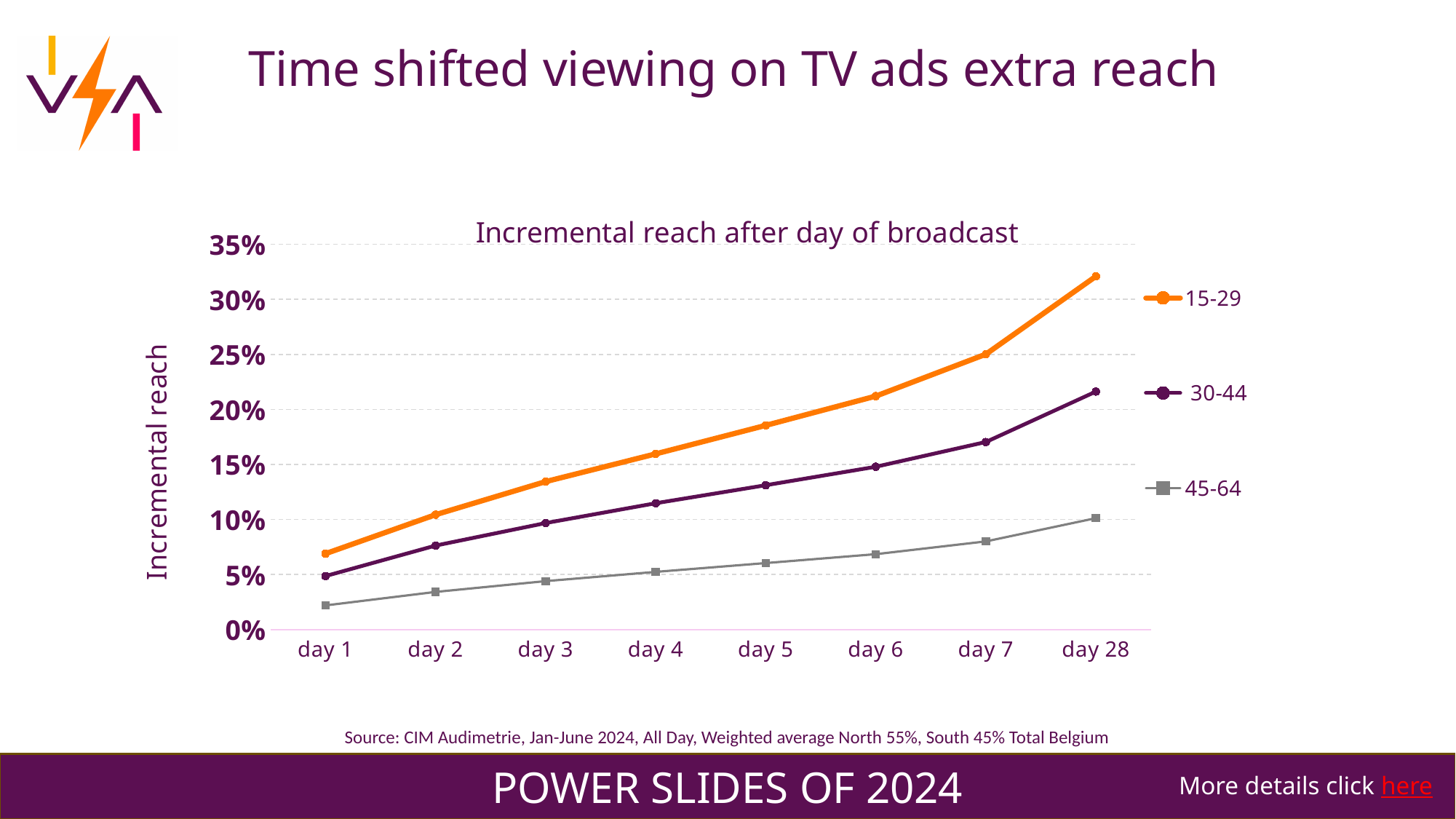
Which is larger at day 4: the value for 30-44 or the value for 45-64? 30-44 How many points are plotted along the x axis for each series? 8 Which age group has the highest incremental reach at day 28? 15-29 Is the value for 30-44 at day 28 greater or less than 20%? greater Do the values for the 15-29 series rise or fall from day 1 to day 28? rise Is the value for 45-64 at day 1 greater or less than 5%? less Which age group has the lowest incremental reach at day 1? 45-64 What is the title of the chart? Incremental reach after day of broadcast How many series does the legend list? 3 Is the value for 45-64 at day 7 greater or less than 10%? less What kind of chart is shown on the slide? line chart